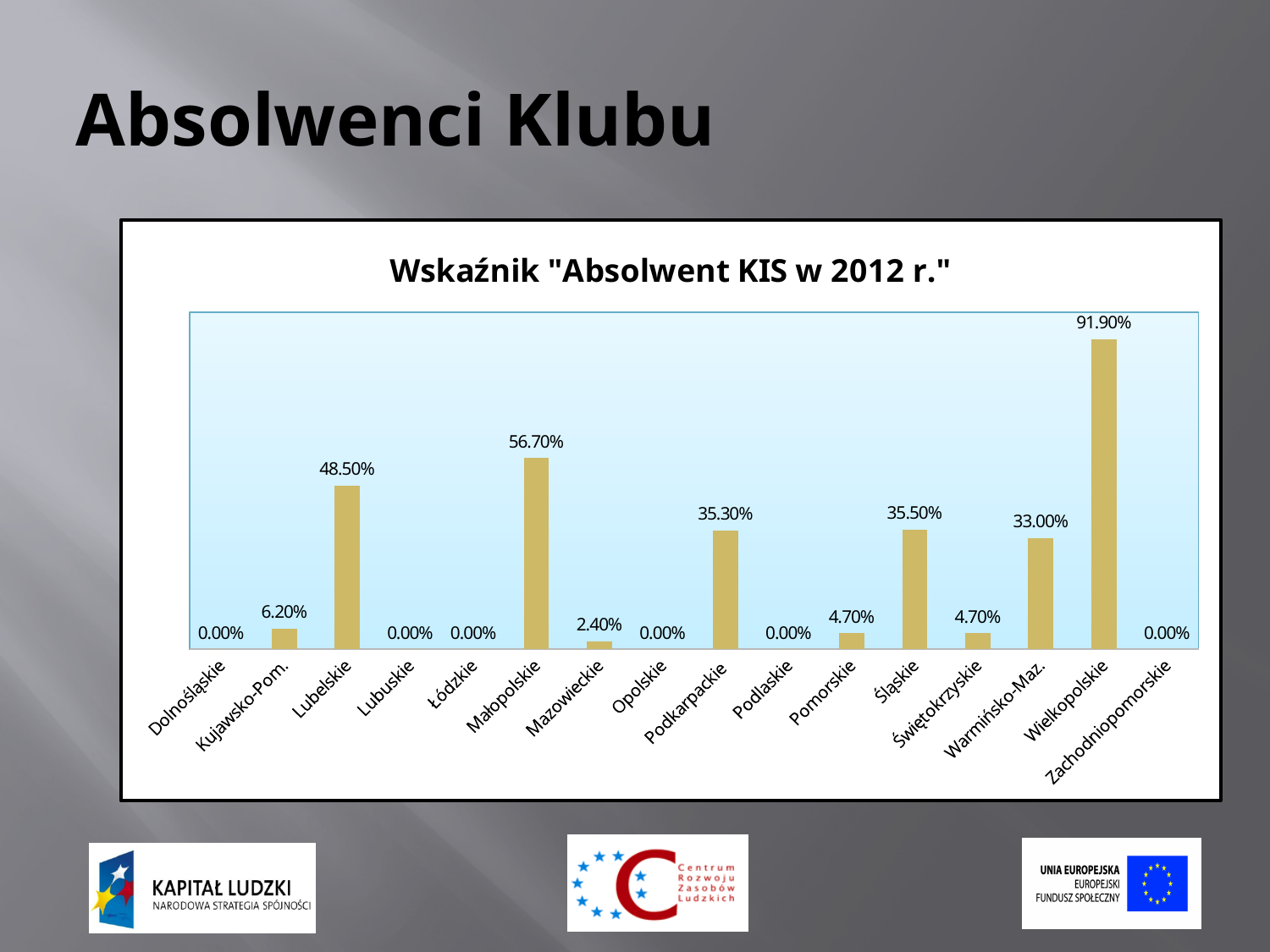
What is the value for Wielkopolskie in the chart "Wskaźnik "Absolwent KIS w 2012 r.""? 91.90% What is the difference between the values for Wielkopolskie and Małopolskie? 35.20% What is the value for Małopolskie? 56.70% What is the title of the chart? Wskaźnik "Absolwent KIS w 2012 r." What is the value for Kujawsko-Pom.? 6.20% What is the value for Mazowieckie? 2.40% What is the value for Warmińsko-Maz.? 33.00% What kind of chart is shown on the slide? Bar chart What is the value for Lubelskie? 48.50% How many categories are shown on the x axis? 16 Which has a larger value, Lubelskie or Małopolskie? Małopolskie Which category has the highest value? Wielkopolskie